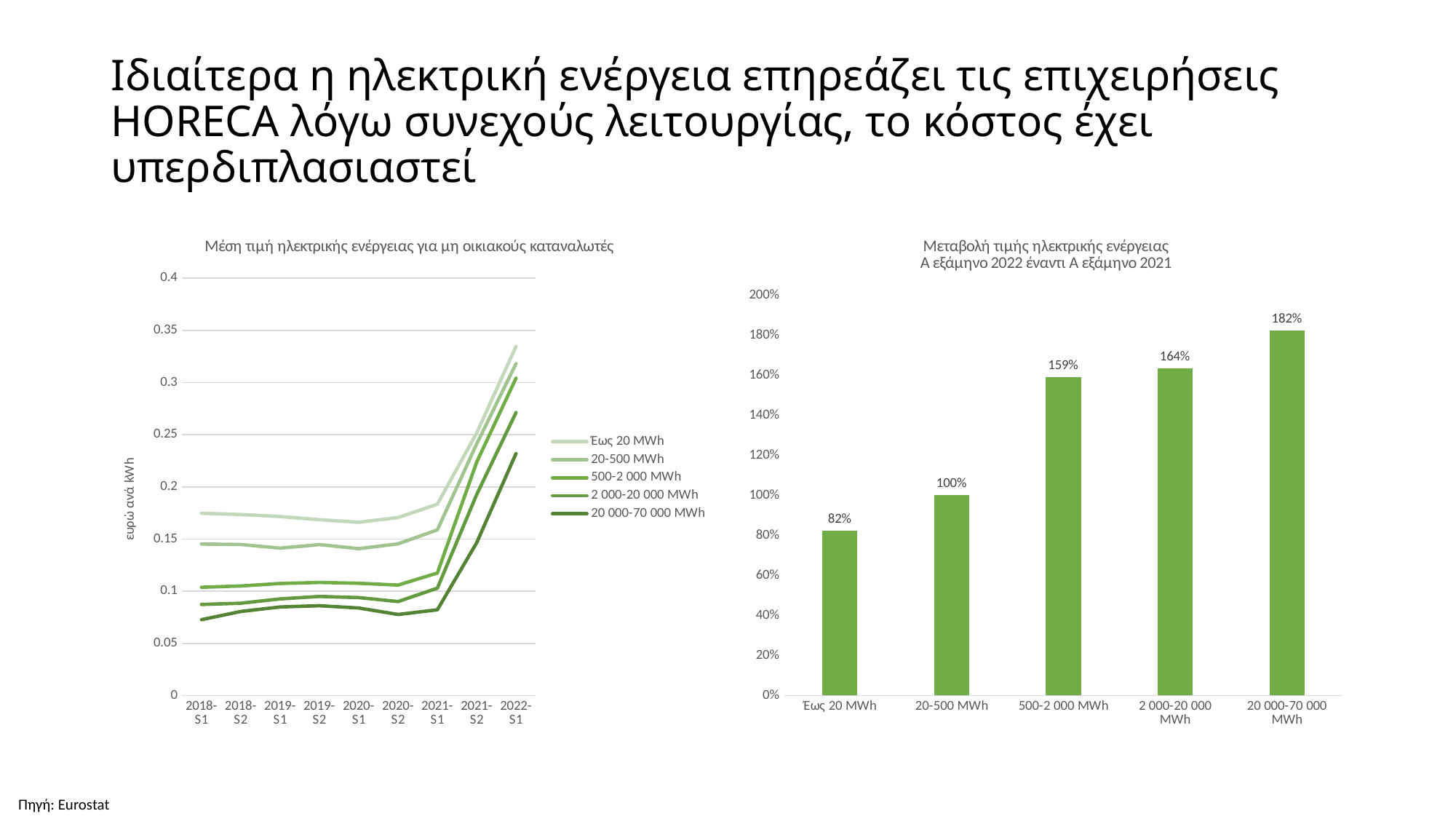
In the left chart (Μέση τιμή ηλεκτρικής ενέργειας για μη οικιακούς καταναλωτές), which series has the highest value at 2022-S1? Έως 20 MWh In the right chart (Μεταβολή τιμής ηλεκτρικής ενέργειας), what is the value for Έως 20 MWh? 82% What kind of chart is the right chart (Μεταβολή τιμής ηλεκτρικής ενέργειας)? Bar chart In the left chart (Μέση τιμή ηλεκτρικής ενέργειας για μη οικιακούς καταναλωτές), is the value for Έως 20 MWh at 2022-S1 greater or less than 0.3? greater In the right chart (Μεταβολή τιμής ηλεκτρικής ενέργειας), what is the value for 500-2 000 MWh? 159% In the right chart (Μεταβολή τιμής ηλεκτρικής ενέργειας), what is the difference between the values for 20 000-70 000 MWh and 20-500 MWh? 82% In the left chart (Μέση τιμή ηλεκτρικής ενέργειας για μη οικιακούς καταναλωτές), how many series does the legend list? 5 In the right chart (Μεταβολή τιμής ηλεκτρικής ενέργειας), which is larger: the value for 2 000-20 000 MWh or the value for 500-2 000 MWh? 2 000-20 000 MWh In the right chart (Μεταβολή τιμής ηλεκτρικής ενέργειας), how many categories are shown? 5 What kind of chart is the left chart (Μέση τιμή ηλεκτρικής ενέργειας για μη οικιακούς καταναλωτές)? Line chart In the right chart (Μεταβολή τιμής ηλεκτρικής ενέργειας), which category has the lowest value? Έως 20 MWh In the right chart (Μεταβολή τιμής ηλεκτρικής ενέργειας), which category has the highest value? 20 000-70 000 MWh